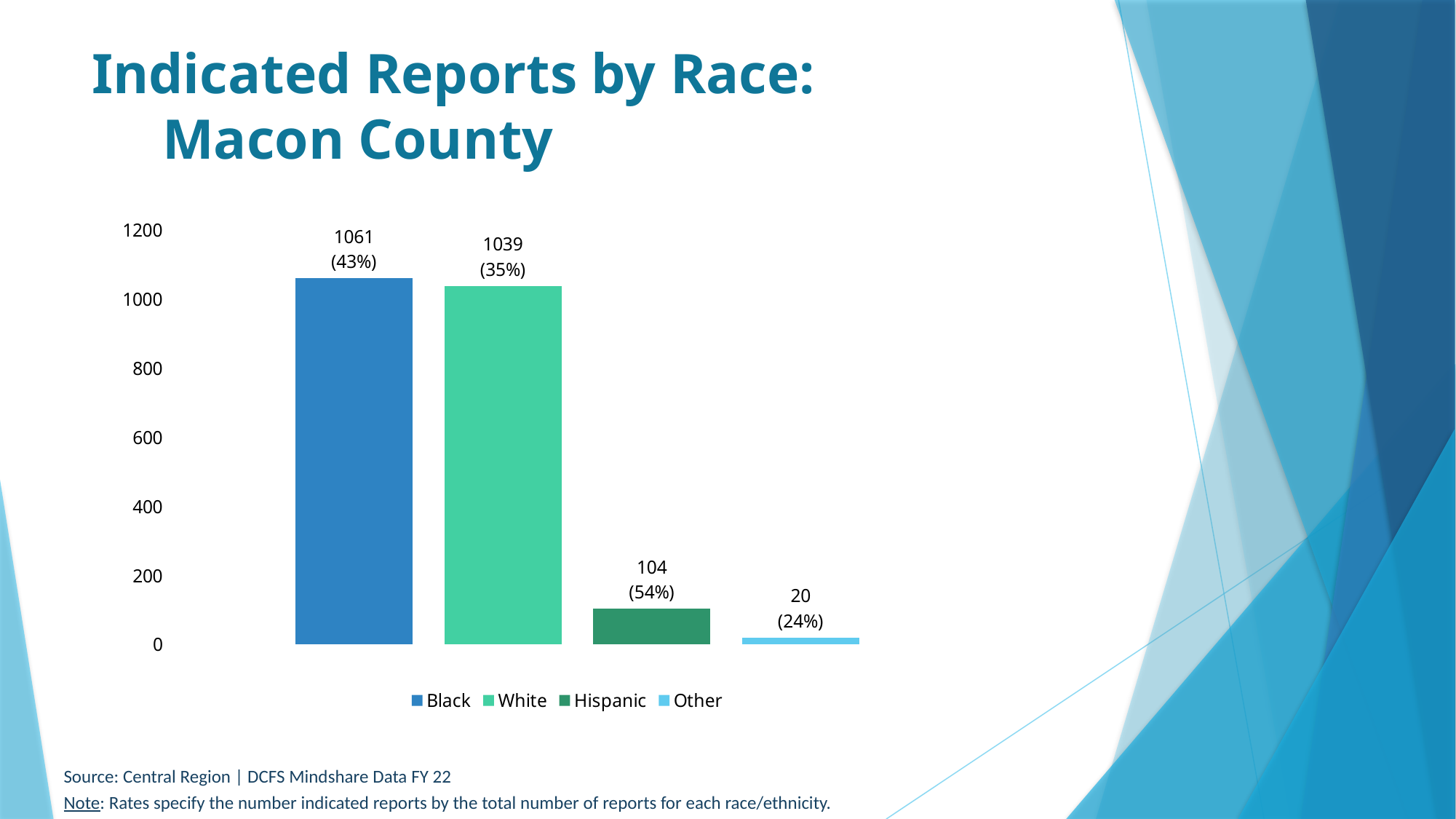
Is the value for White greater or less than 1000? greater What is the number of indicated reports for Black? 1061 Which race has the lowest number of indicated reports? Other Which has more indicated reports, Hispanic or Other? Hispanic How many race categories are shown in the chart? 4 What is the number of indicated reports for Hispanic? 104 What kind of chart is shown on the slide? Bar chart What is the title of the slide? Indicated Reports by Race: Macon County What is the difference between the number of indicated reports for Black and White? 22 What percentage is shown for Other? 24% Which race has the highest number of indicated reports? Black What is the number of indicated reports for White? 1039